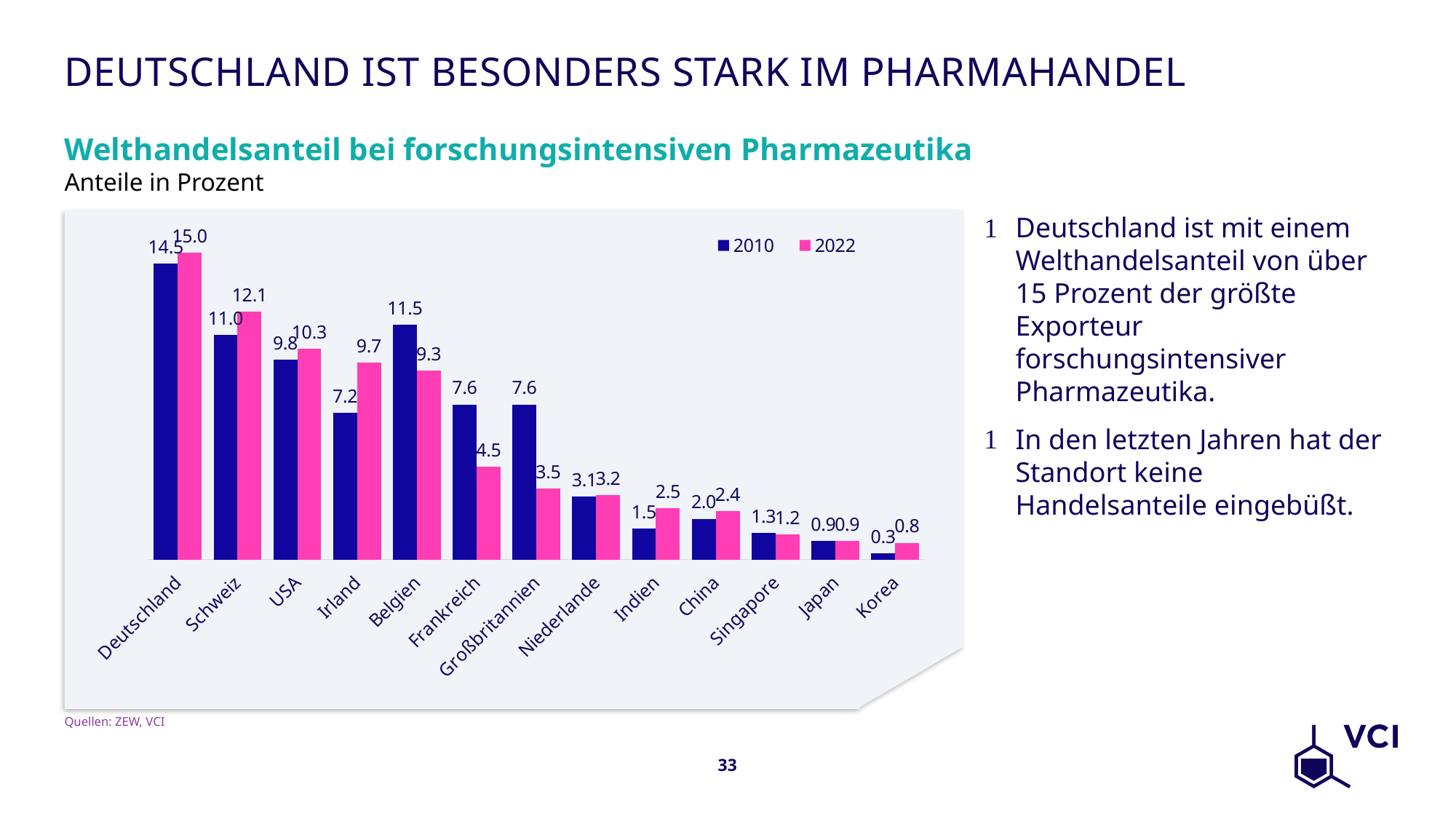
Which two years are listed in the chart legend? 2010 and 2022 What is the value for Großbritannien in the 2022 series? 3.5 What is the value for Deutschland in the 2022 series? 15.0 Which country has the highest value in the 2022 series? Deutschland Which country has the lowest value in the 2010 series? Korea How many countries are shown on the x axis? 13 In the 2010 series, which is larger: Belgien or Schweiz? Belgien What kind of chart is shown on the slide? Bar chart What is the value for Irland in the 2022 series? 9.7 How many series does the legend list? 2 By how much did the value for Frankreich fall from 2010 to 2022? 3.1 What is the value for Belgien in the 2010 series? 11.5